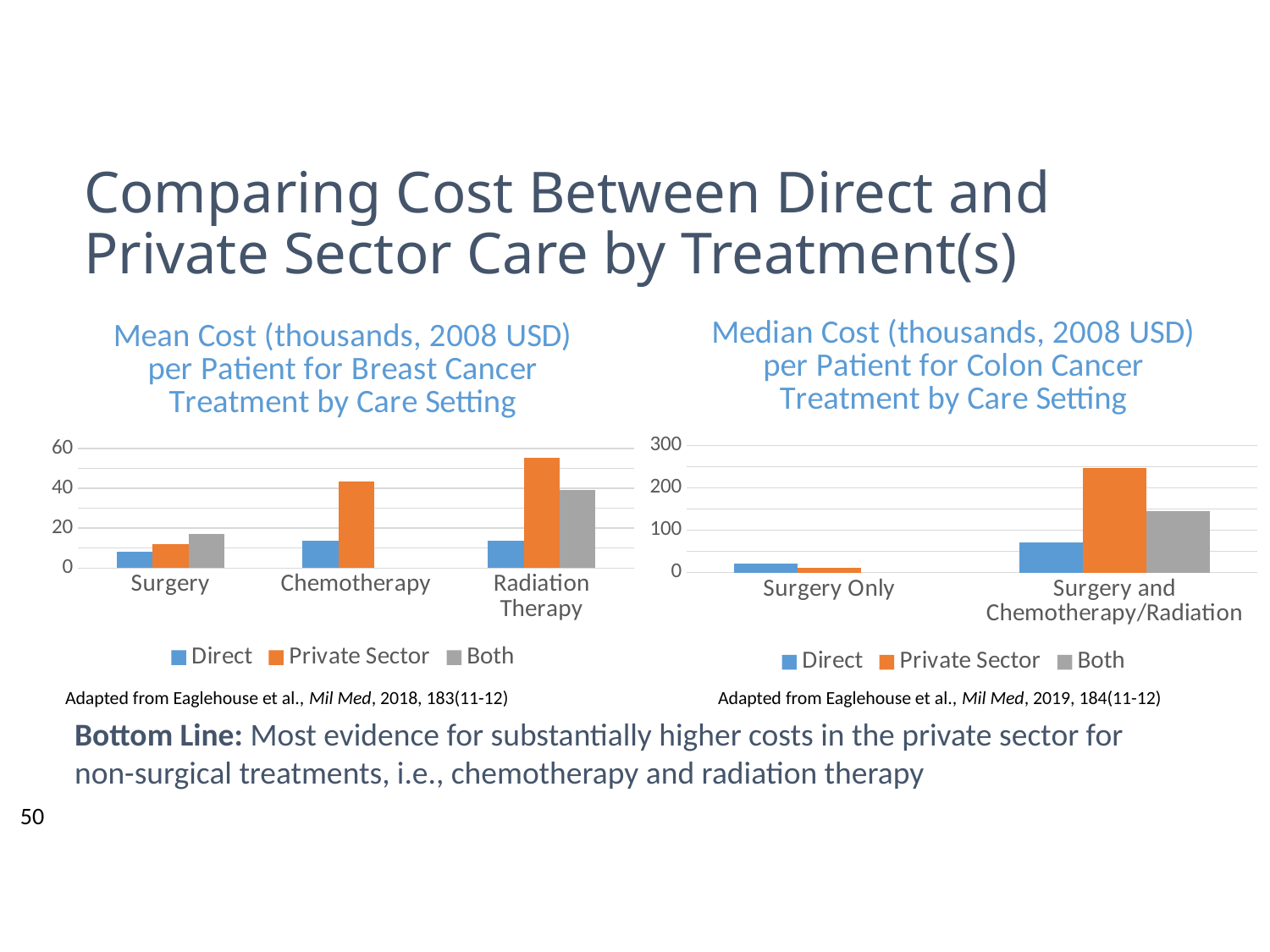
In the right chart (Median Cost for Colon Cancer Treatment), is the Private Sector value for Surgery and Chemotherapy/Radiation greater or less than 200? greater In the left chart (Mean Cost for Breast Cancer Treatment), how many series does the legend list? 3 In the right chart (Median Cost for Colon Cancer Treatment), which series has the highest value for Surgery Only? Direct In the left chart (Mean Cost for Breast Cancer Treatment), which treatment has the highest Private Sector cost? Radiation Therapy In the left chart (Mean Cost for Breast Cancer Treatment), is the Direct value for Surgery greater or less than 20? less In the right chart (Median Cost for Colon Cancer Treatment), is the Both value for Surgery and Chemotherapy/Radiation greater or less than 100? greater In the right chart (Median Cost for Colon Cancer Treatment), how many treatment categories are shown on the x axis? 2 In the left chart (Mean Cost for Breast Cancer Treatment), for Chemotherapy, which is larger: the Direct cost or the Private Sector cost? Private Sector In the left chart (Mean Cost for Breast Cancer Treatment), how many treatment categories are shown on the x axis? 3 What is the title of the right chart on the slide? Median Cost (thousands, 2008 USD) per Patient for Colon Cancer Treatment by Care Setting What kind of chart is the left chart, 'Mean Cost (thousands, 2008 USD) per Patient for Breast Cancer Treatment by Care Setting'? Bar chart